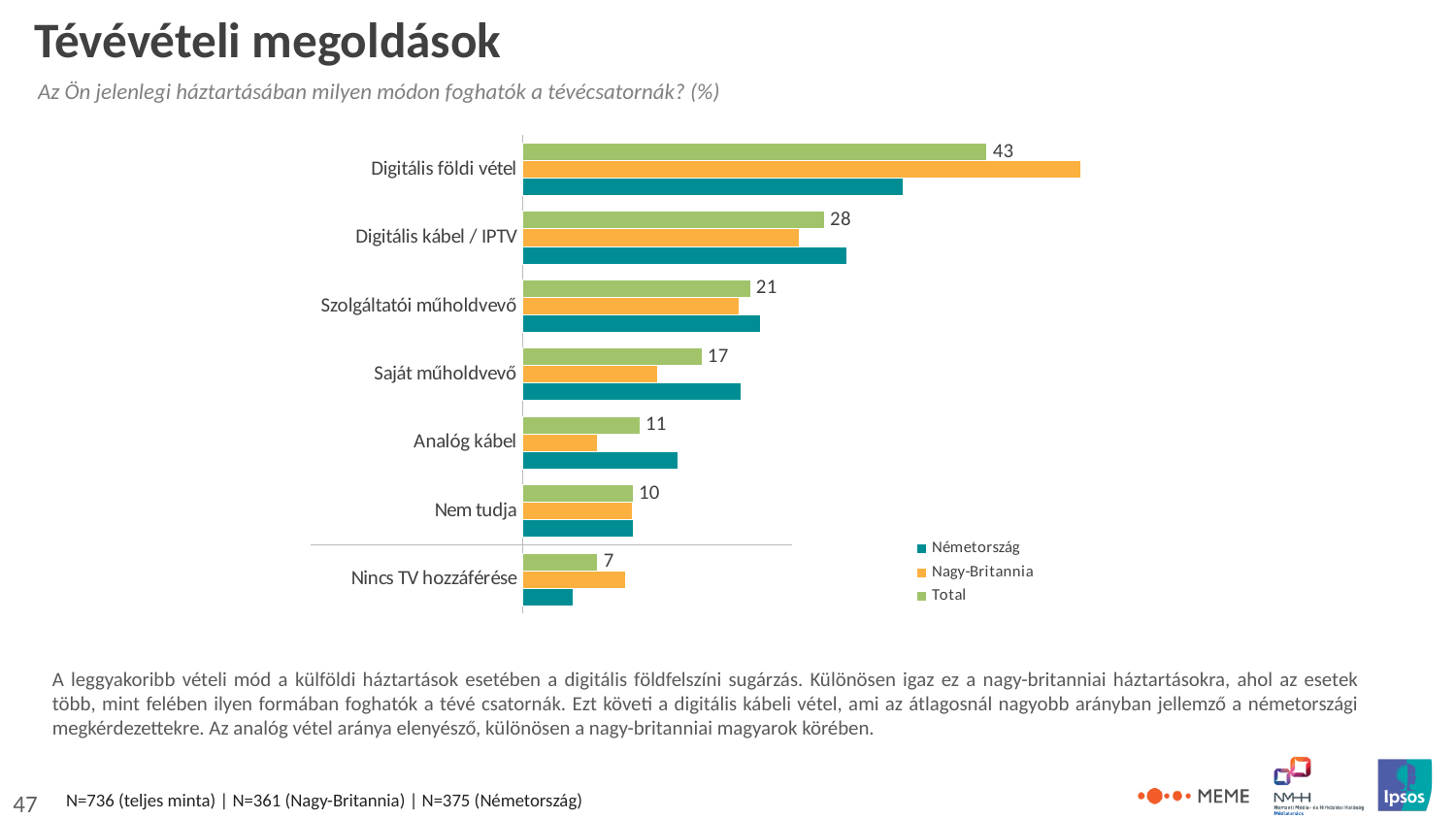
What kind of chart is shown on the slide? Bar chart How many series does the legend list? 3 How many categories are shown on the chart? 7 What is the Total value for Nincs TV hozzáférése? 7 Which category has the highest Total value? Digitális földi vétel What is the difference between the Total values for Digitális földi vétel and Digitális kábel / IPTV? 15 Which category has the lowest Total value? Nincs TV hozzáférése What is the Total value for Digitális földi vétel? 43 What is the Total value for Digitális kábel / IPTV? 28 For Analóg kábel, which is larger: the Németország bar or the Nagy-Britannia bar? Németország What is the Total value for Saját műholdvevő? 17 For Digitális földi vétel, which is larger: the Nagy-Britannia bar or the Németország bar? Nagy-Britannia